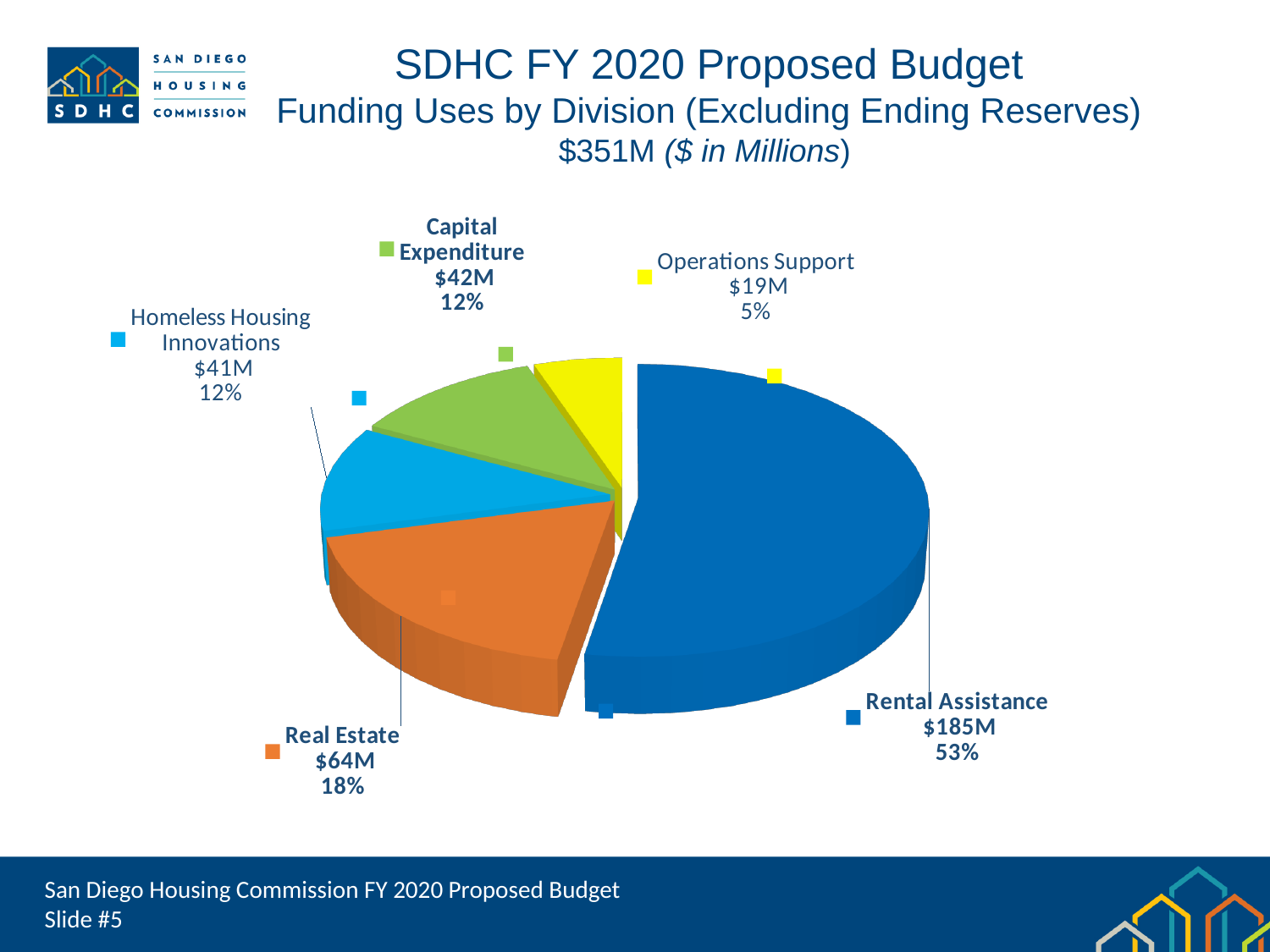
What is the difference in value between Rental Assistance and Real Estate? $121M What is the value for Real Estate? $64M Which is larger, the value for Real Estate or the value for Capital Expenditure? Real Estate What type of chart is shown on the slide? Pie chart Which division has the smallest share of the pie? Operations Support What percentage share of the pie does Capital Expenditure represent? 12% What is the value for Operations Support? $19M What is the value for Homeless Housing Innovations? $41M Which division has the largest share of the pie? Rental Assistance What is the value for Rental Assistance? $185M How many divisions are shown in the pie chart? 5 What percentage share of the pie does Rental Assistance represent? 53%